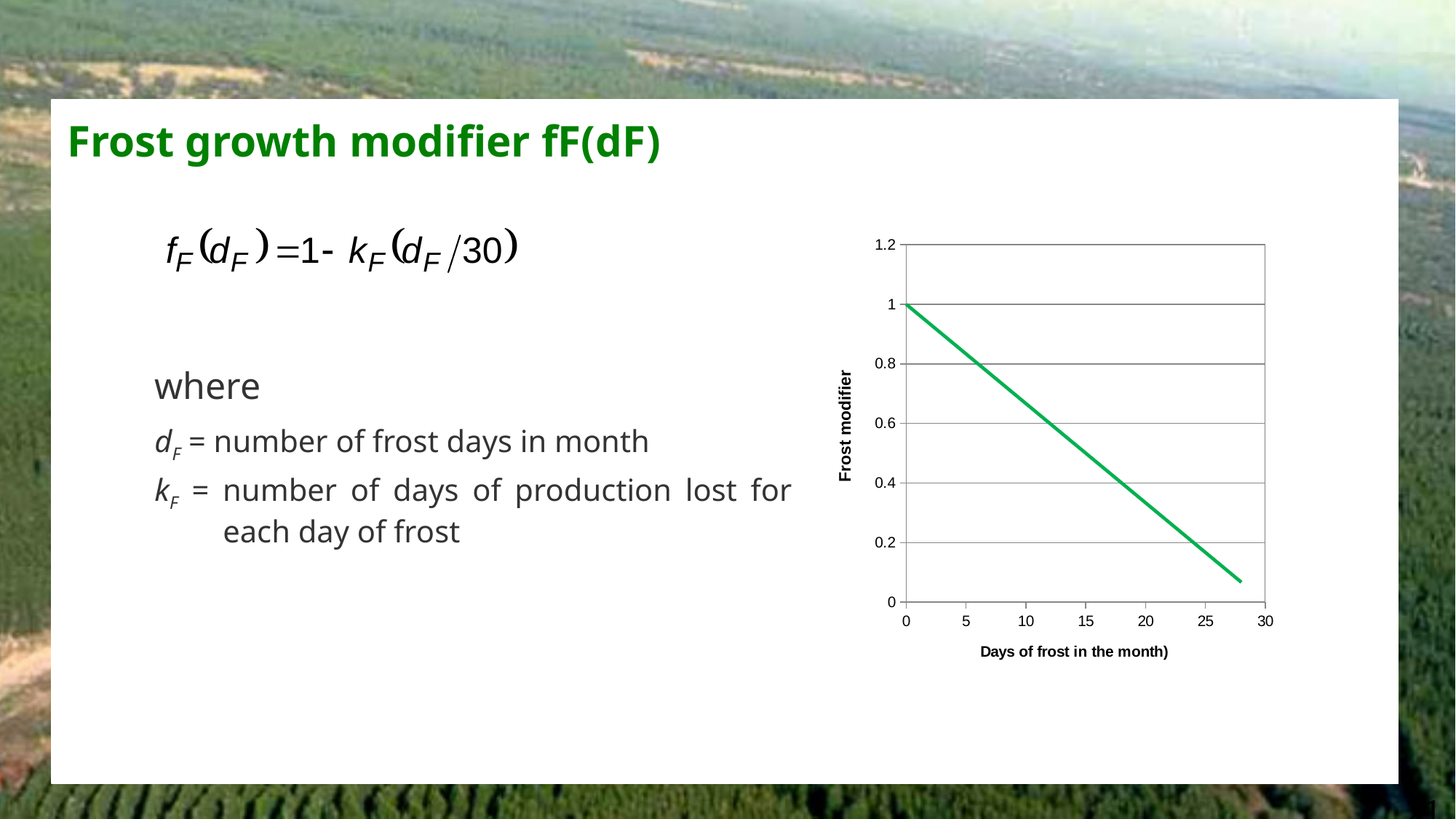
At how many days of frost is the frost modifier highest? 0 Is the frost modifier at 10 days of frost greater or less than 0.6? greater Does the frost modifier rise or fall as the days of frost in the month increase? fall What is the highest tick value shown on the vertical axis? 1.2 What kind of chart is shown on the slide? line chart Is the frost modifier at 25 days of frost greater or less than 0.4? less What is the label on the vertical axis of the chart? Frost modifier Which is larger, the frost modifier at 5 days of frost or at 25 days of frost? 5 days of frost What is the frost modifier value at 0 days of frost? 1 Is the frost modifier at 15 days of frost greater or less than 0.6? less